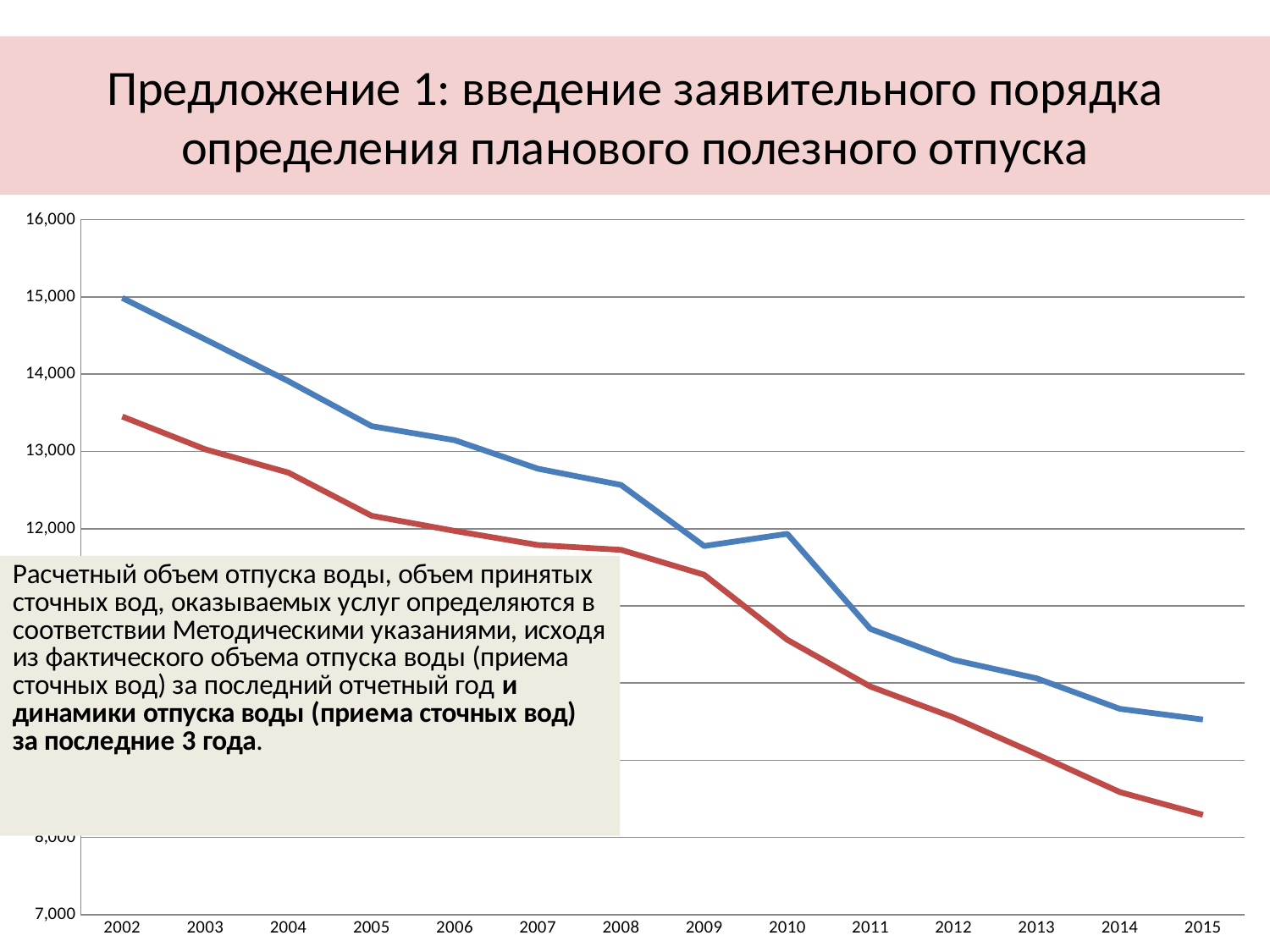
Is the value of the blue line in 2002 greater or less than 14,000? greater What is the first year shown on the x axis? 2002 What is the last year shown on the x axis? 2015 Is the value of the red line in 2008 greater or less than 12,000? less In which year is the red line at its lowest value? 2015 How many lines are plotted on the chart? 2 What kind of chart is shown on the slide? line chart Which line has the higher value in 2002, the blue line or the red line? blue line Is the value of the blue line in 2009 greater or less than 12,000? less Do the values of the blue line rise or fall from 2002 to 2015? fall How many years are shown along the x axis of the chart? 14 In which year is the blue line at its highest value? 2002